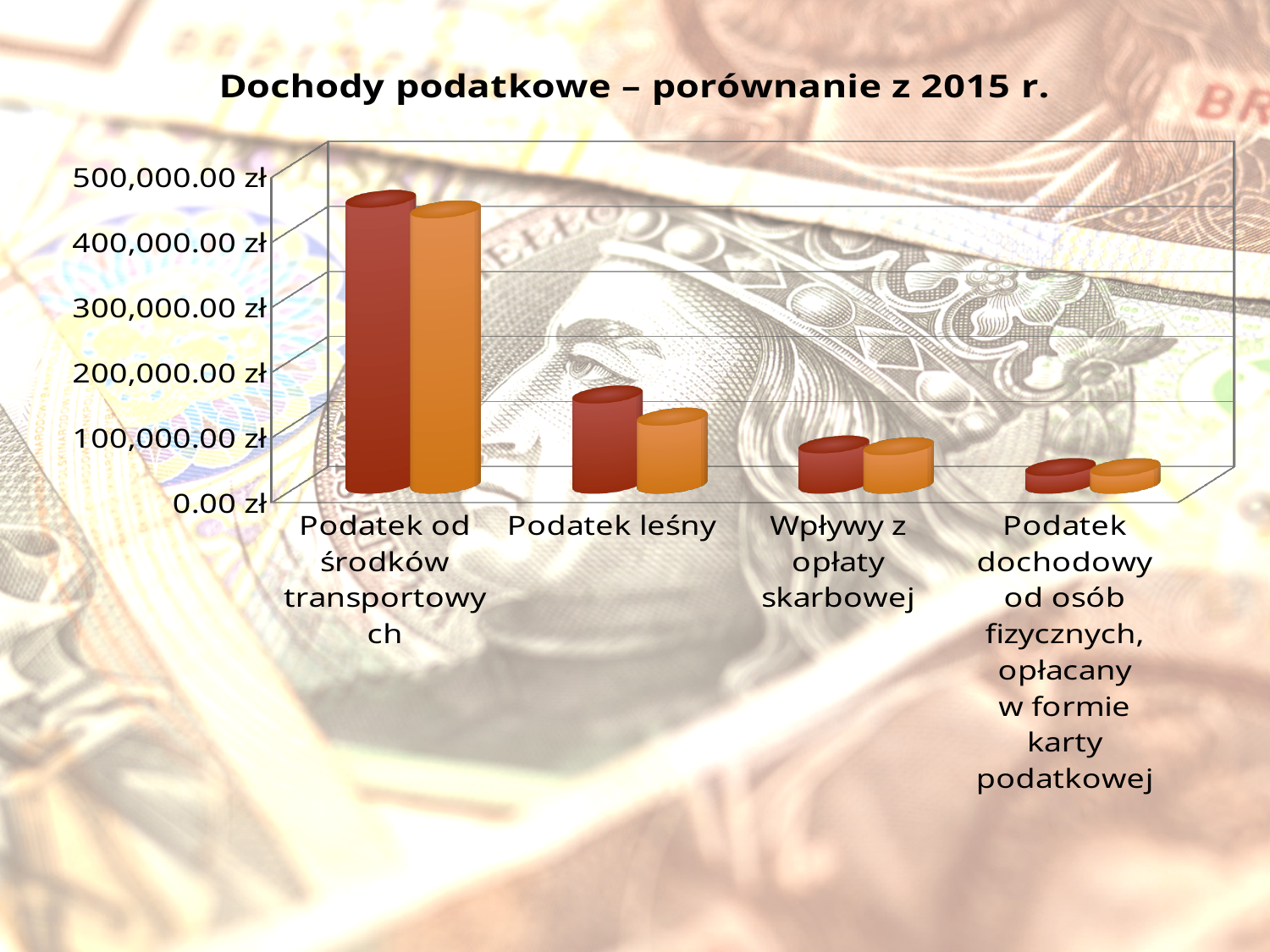
Which category has the lowest values in the chart? Podatek dochodowy od osób fizycznych, opłacany w formie karty podatkowej Which category has the highest values in the chart? Podatek od środków transportowych Is the value of the dark red bar for Wpływy z opłaty skarbowej greater or less than 100,000.00 zł? less What is the title of the chart? Dochody podatkowe – porównanie z 2015 r. Is the value of the orange bar for Podatek dochodowy od osób fizycznych, opłacany w formie karty podatkowej greater or less than 100,000.00 zł? less Which category has larger values, Podatek leśny or Wpływy z opłaty skarbowej? Podatek leśny Do the values rise or fall moving from left to right along the x axis? fall Is the value of the dark red bar for Podatek leśny greater or less than 100,000.00 zł? greater For Podatek leśny, which bar is larger, the dark red one or the orange one? the dark red one What kind of chart is shown on the slide? bar chart How many categories are shown on the x axis of the chart? 4